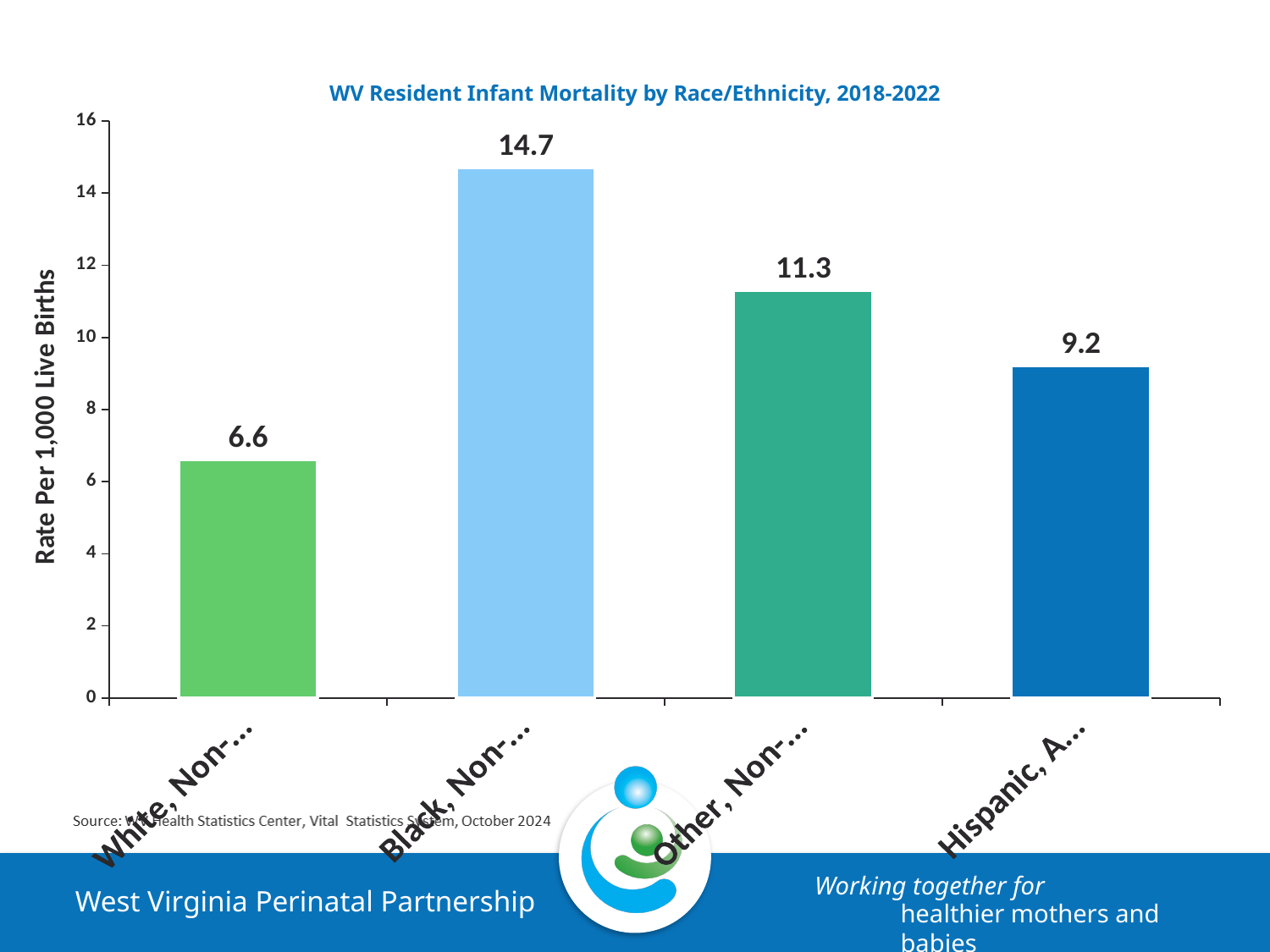
Which category has the highest infant mortality rate? Black, Non-... What is the label of the vertical axis? Rate Per 1,000 Live Births What is the infant mortality rate for the "Black, Non-..." category? 14.7 What type of chart is shown on the slide? Bar chart How many categories are shown in the chart? 4 Which category has the lowest infant mortality rate? White, Non-... What is the difference between the rates for the "Black, Non-..." and "White, Non-..." categories? 8.1 Which is larger, the rate for "Other, Non-..." or the rate for "Hispanic, A..."? Other, Non-... What is the infant mortality rate for the "Hispanic, A..." category? 9.2 Is the value for "Hispanic, A..." greater or less than 10? less What is the infant mortality rate for the "Other, Non-..." category? 11.3 What is the infant mortality rate for the "White, Non-..." category? 6.6